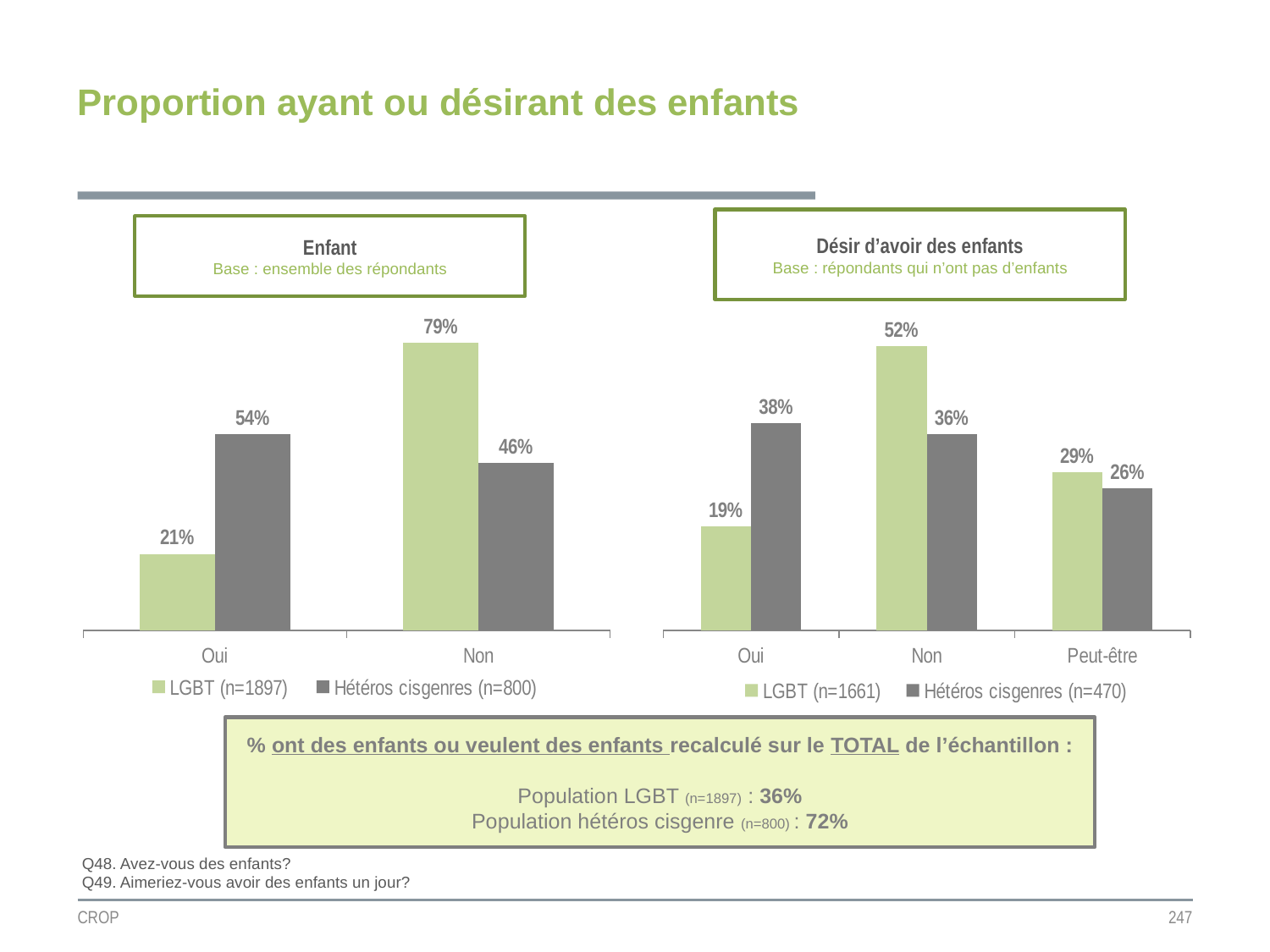
In the 'Enfant' chart, what is the value for LGBT (n=1897) in the 'Oui' category? 21% In the 'Désir d'avoir des enfants' chart, what is the difference between the Hétéros cisgenres and LGBT values for 'Oui'? 19% In the 'Désir d'avoir des enfants' chart, what is the value for Hétéros cisgenres (n=470) in the 'Peut-être' category? 26% In the 'Désir d'avoir des enfants' chart, which category has the highest value for LGBT (n=1661)? Non In the 'Désir d'avoir des enfants' chart, what is the value for LGBT (n=1661) in the 'Non' category? 52% In the 'Désir d'avoir des enfants' chart, which category has the lowest value for Hétéros cisgenres (n=470)? Peut-être In the 'Enfant' chart, which is larger for 'Oui': the LGBT value or the Hétéros cisgenres value? Hétéros cisgenres What kind of chart is the 'Enfant' chart? Bar chart How many categories are shown on the x axis of the 'Désir d'avoir des enfants' chart? 3 In the 'Enfant' chart, what is the value for Hétéros cisgenres (n=800) in the 'Non' category? 46% How many series does the legend of the 'Enfant' chart list? 2 In the 'Enfant' chart, what is the difference between the LGBT and Hétéros cisgenres values for 'Non'? 33%